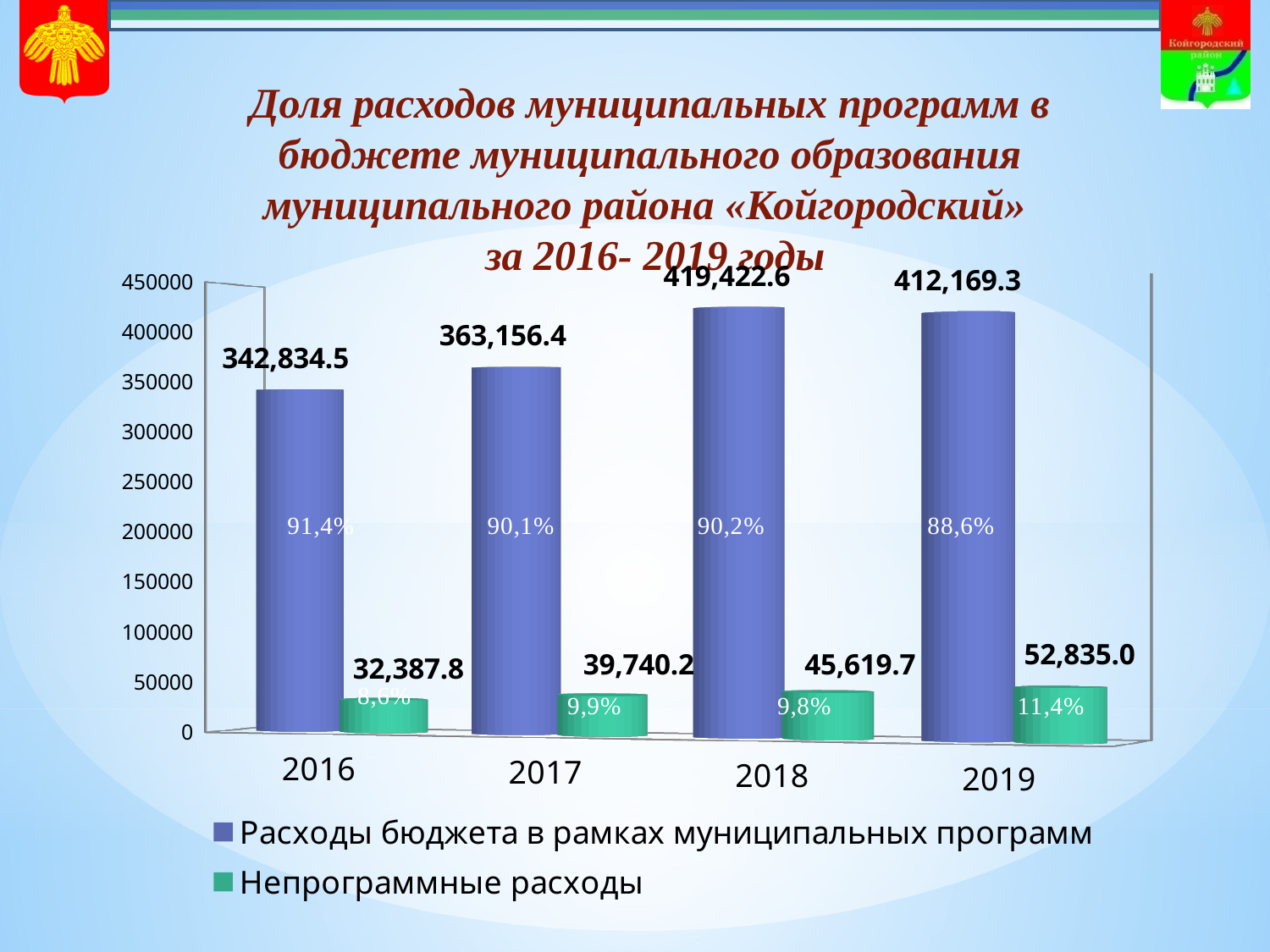
Which is larger: Расходы бюджета в рамках муниципальных программ in 2016 or in 2017? 2017 Do the values for Непрограммные расходы rise or fall from 2016 to 2019? rise How many series does the legend list? 2 What is the value for Непрограммные расходы in 2016? 32,387.8 What is the value for Расходы бюджета в рамках муниципальных программ in 2018? 419,422.6 What percentage is printed on the Расходы бюджета в рамках муниципальных программ bar for 2019? 88,6% In which year is Непрограммные расходы lowest? 2016 What is the difference between Расходы бюджета в рамках муниципальных программ in 2018 and in 2019? 7,253.3 How many years are shown on the x axis? 4 Is the value for Непрограммные расходы in 2019 greater or less than 50000? greater In which year is Расходы бюджета в рамках муниципальных программ highest? 2018 What is the difference between Непрограммные расходы in 2019 and in 2016? 20,447.2